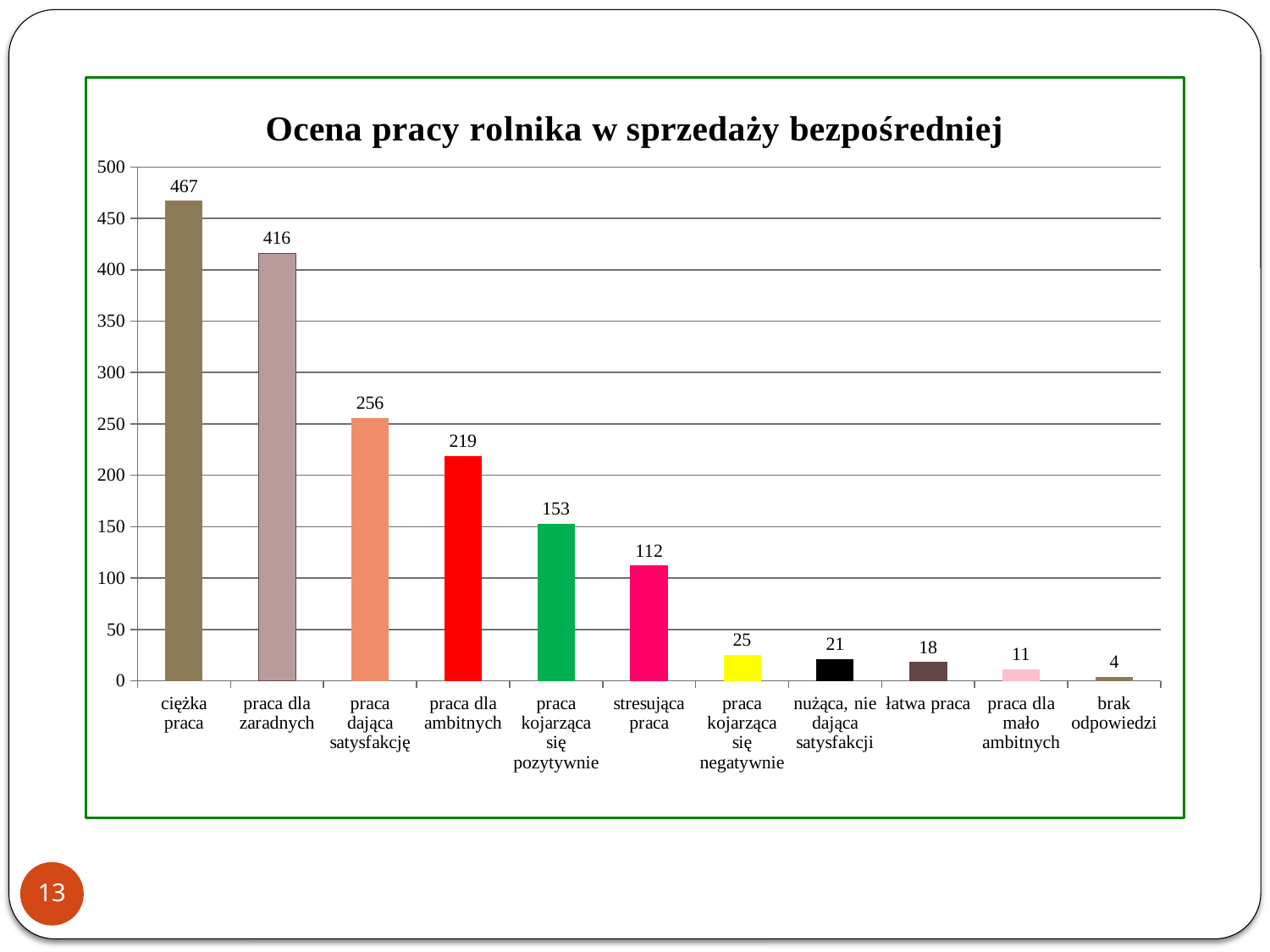
Is the value for "praca kojarząca się pozytywnie" greater or less than 200? less What kind of chart is shown on the slide? bar chart Which category has the lowest value? brak odpowiedzi What is the value for "ciężka praca"? 467 What is the difference between the values for "ciężka praca" and "praca dla zaradnych"? 51 Do the values rise or fall from left to right along the x axis? fall Which is larger: the value for "praca dająca satysfakcję" or the value for "praca dla ambitnych"? praca dająca satysfakcję Which category has the highest value? ciężka praca What is the value for "łatwa praca"? 18 What is the title of the chart? Ocena pracy rolnika w sprzedaży bezpośredniej What is the value for "stresująca praca"? 112 How many categories are shown on the x axis? 11